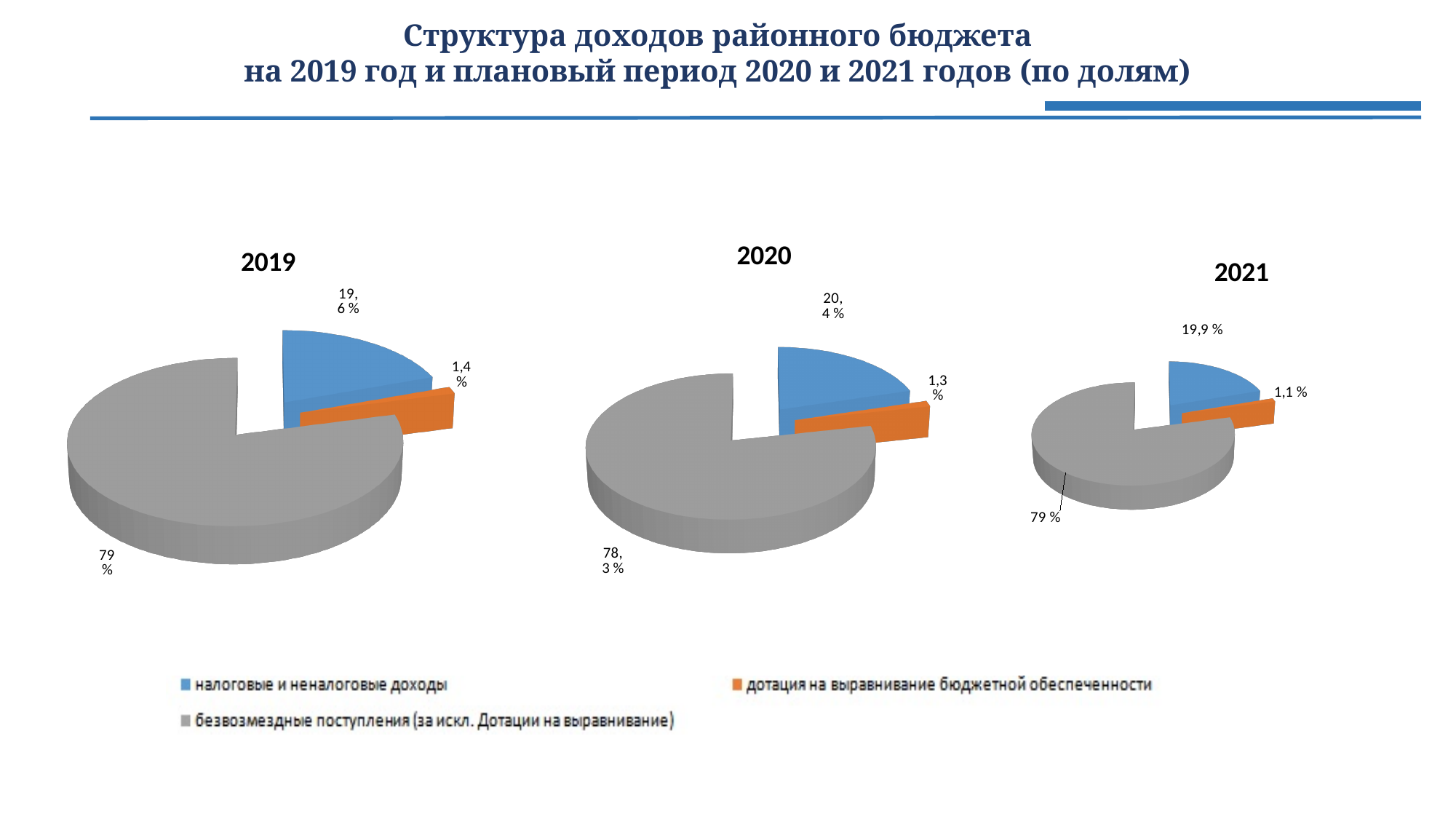
How many categories does the legend list for the pie charts? 3 In the 2021 pie chart, what share is shown for дотация на выравнивание бюджетной обеспеченности? 1,1 % In the 2019 pie chart, which category has the smallest share? дотация на выравнивание бюджетной обеспеченности In the 2021 pie chart, which is larger: the share for налоговые и неналоговые доходы or the share for дотация на выравнивание бюджетной обеспеченности? налоговые и неналоговые доходы In the 2019 pie chart, what share is shown for дотация на выравнивание бюджетной обеспеченности? 1,4 % Which colour represents налоговые и неналоговые доходы in the pie charts? blue In the 2019 pie chart, what share is shown for налоговые и неналоговые доходы? 19,6 % In the 2020 pie chart, what share is shown for налоговые и неналоговые доходы? 20,4 % In the 2020 pie chart, what share is shown for безвозмездные поступления (за искл. Дотации на выравнивание)? 78,3 % What type of chart is used for the 2019, 2020 and 2021 charts on this slide? pie chart In the 2020 pie chart, which category has the largest share? безвозмездные поступления (за искл. Дотации на выравнивание) In the 2021 pie chart, what share is shown for безвозмездные поступления (за искл. Дотации на выравнивание)? 79 %